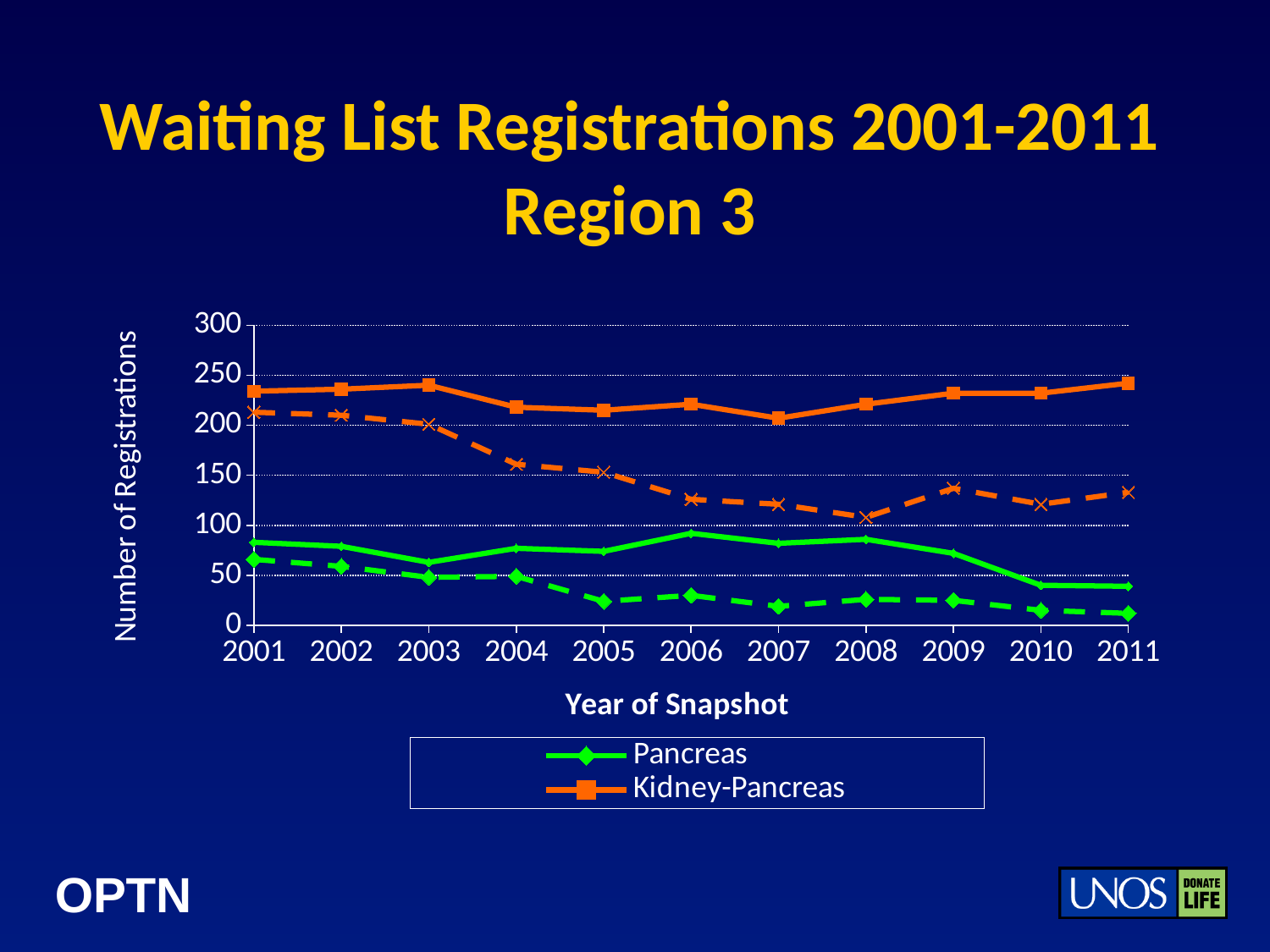
Is the Kidney-Pancreas value for 2007 greater or less than 250? less Is the Kidney-Pancreas value for 2001 greater or less than 200? greater Is the Pancreas value for 2011 greater or less than 50? less How many years are shown along the x axis? 11 Does the Pancreas line rise or fall from 2008 to 2011? fall In 2011, which series has the higher value, Pancreas or Kidney-Pancreas? Kidney-Pancreas What kind of chart is shown on the slide? line chart How many series does the legend list? 2 What is the title of the x axis? Year of Snapshot What is the title of the y axis? Number of Registrations